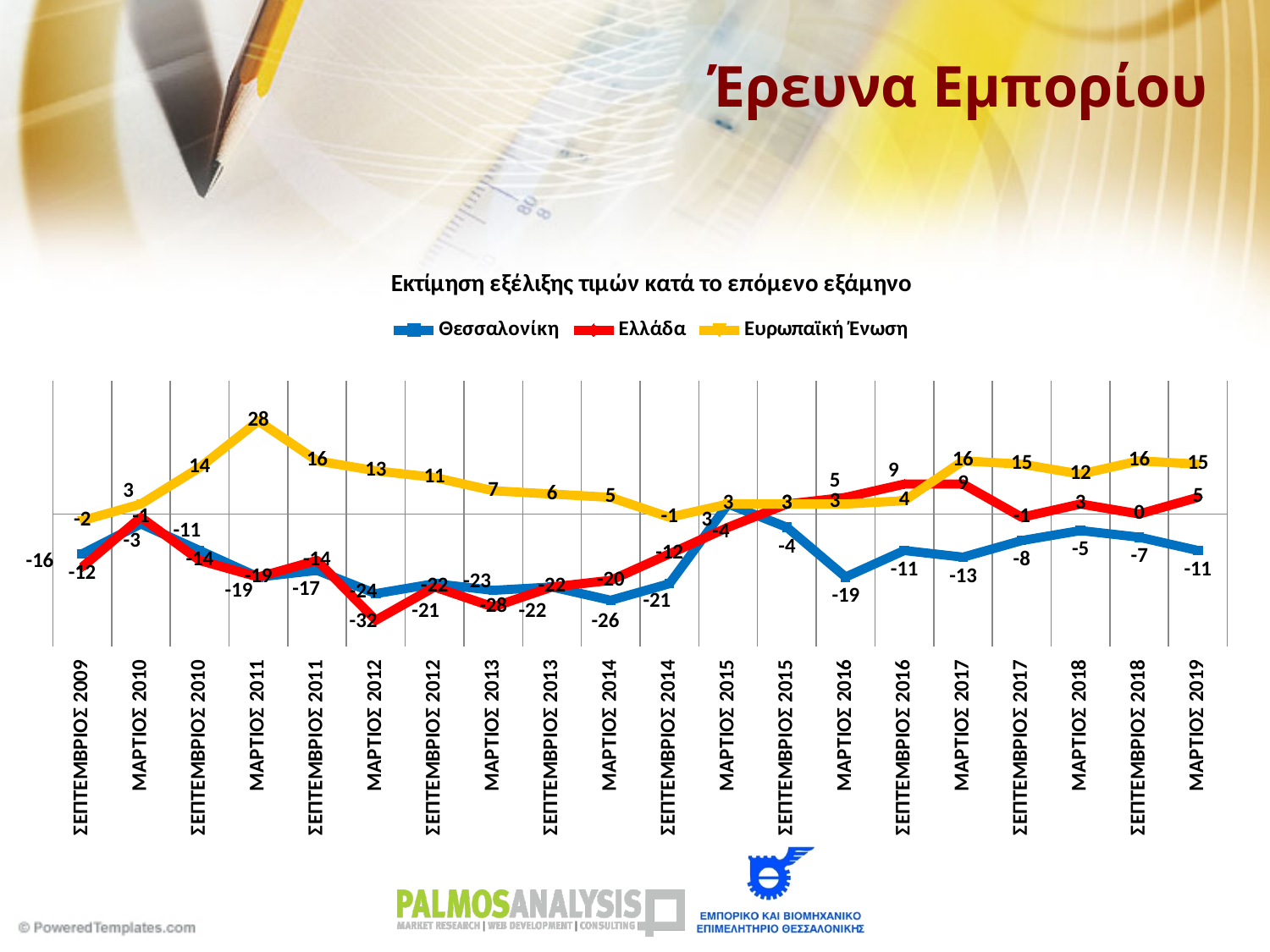
In which period does Ευρωπαϊκή Ένωση reach its highest value? ΜΑΡΤΙΟΣ 2011 What is the value for Ευρωπαϊκή Ένωση in ΜΑΡΤΙΟΣ 2011? 28 What is the difference between Ευρωπαϊκή Ένωση and Θεσσαλονίκη in ΜΑΡΤΙΟΣ 2019? 26 What is the value for Ελλάδα in ΜΑΡΤΙΟΣ 2012? -32 Which colour represents Ελλάδα in the chart? red What is the value for Ελλάδα in ΣΕΠΤΕΜΒΡΙΟΣ 2018? 0 What type of chart is shown on the slide? line chart What is the value for Θεσσαλονίκη in ΜΑΡΤΙΟΣ 2016? -19 In which period does Ελλάδα reach its lowest value? ΜΑΡΤΙΟΣ 2012 Which is larger in ΣΕΠΤΕΜΒΡΙΟΣ 2016, the value for Ελλάδα or the value for Θεσσαλονίκη? Ελλάδα How many time points are shown on the x axis? 20 How many series does the legend list? 3